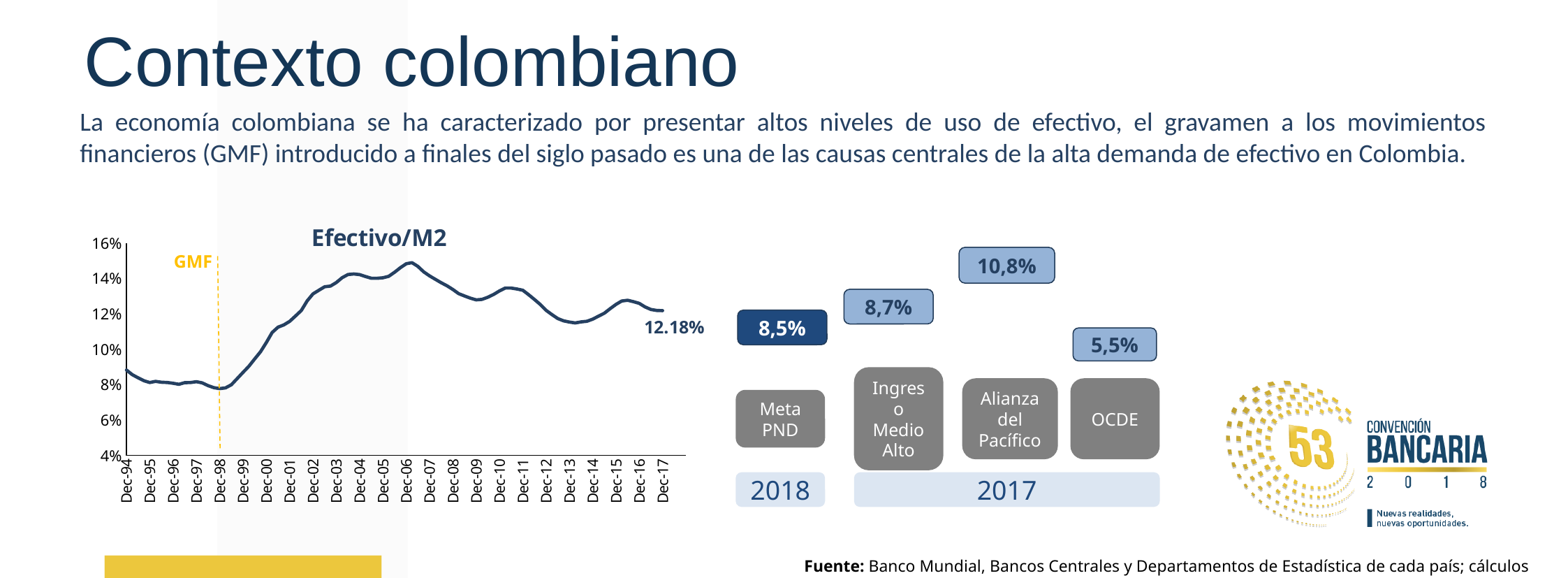
In the Efectivo/M2 chart, is the value at Dec-06 greater or less than 14%? greater In the boxes on the right, what is the difference between the Alianza del Pacífico value and the OCDE value? 5,3% In the boxes on the right, what value is shown for Alianza del Pacífico? 10,8% In the Efectivo/M2 chart, is the value at Dec-94 greater or less than 10%? less In the Efectivo/M2 chart, what value is labelled at Dec-17? 12.18% In the Efectivo/M2 chart, at which x-axis date is the dashed GMF line placed? Dec-98 In the Efectivo/M2 chart, around which date does the line reach its highest point? Dec-06 What kind of chart is the Efectivo/M2 chart on the left? line chart In the Efectivo/M2 chart, does the line rise or fall between Dec-98 and Dec-06? rise In the Efectivo/M2 chart, is the value at Dec-13 greater or less than 10%? greater What is the title of the line chart on the left? Efectivo/M2 In the Efectivo/M2 chart, how many dates are labelled on the x axis? 24